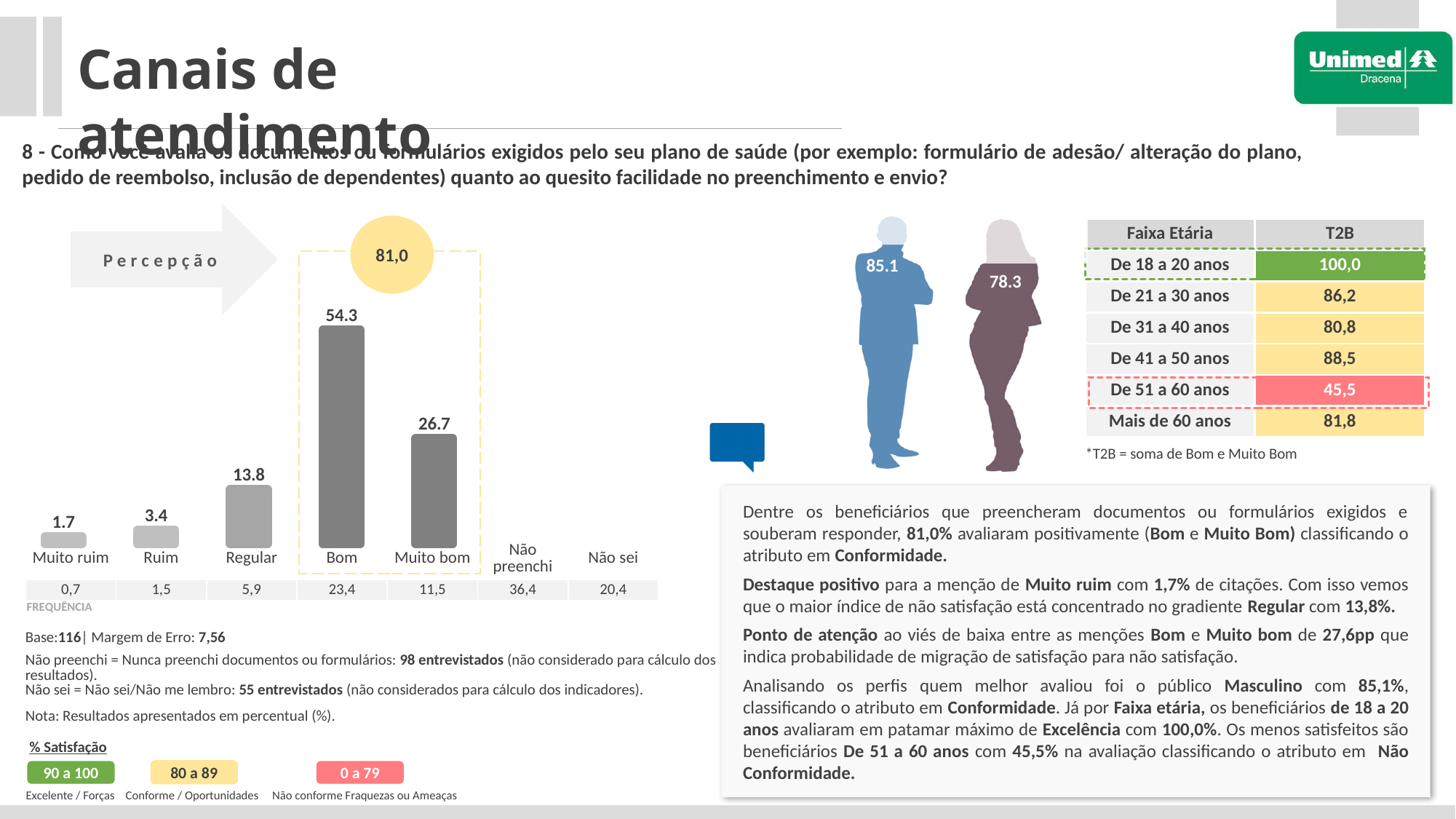
In the bar chart, which category has the highest value? Bom In the bar chart, do the values rise or fall from Muito ruim to Bom? rise In the bar chart, what is the value for Muito ruim? 1.7 In the bar chart, what combined value is shown in the yellow circle above the Bom and Muito bom bars? 81,0 In the bar chart, what is the value for Bom? 54.3 In the bar chart, how many bars are plotted with values? 5 In the bar chart, which category has the lowest plotted value? Muito ruim In the bar chart, which is larger, the value for Ruim or the value for Regular? Regular In the bar chart, what is the value for Regular? 13.8 In the bar chart, what is the value for Muito bom? 26.7 What kind of chart is shown on the left of the slide? bar chart In the bar chart, what is the difference between the values for Bom and Muito bom? 27.6